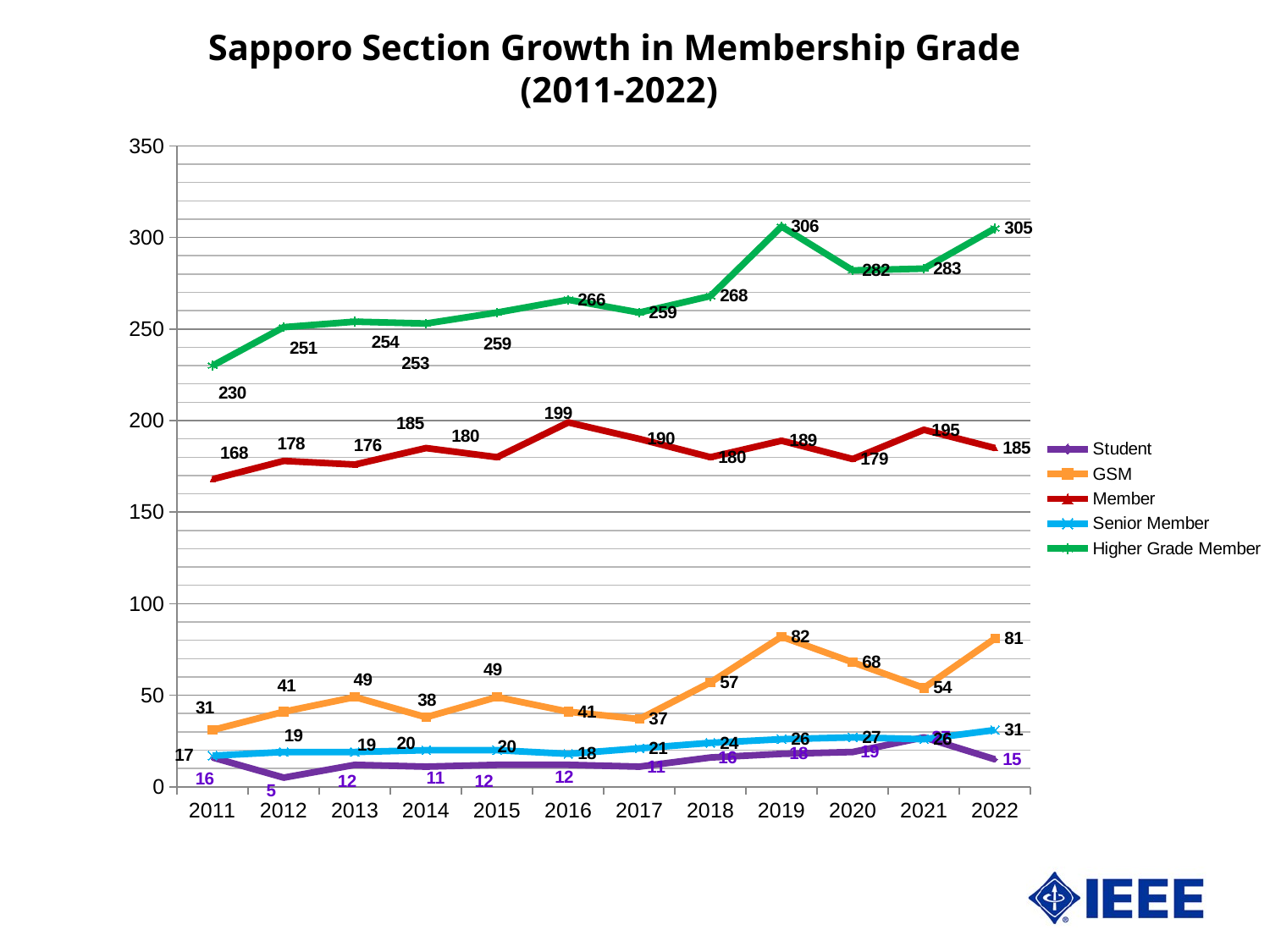
Which is larger, the GSM value in 2019 or in 2022? 2019 What is the value for GSM in 2019? 82 What is the value for Higher Grade Member in 2019? 306 How many years are plotted on the x axis? 12 What kind of chart is shown on the slide? line chart What is the value for Member in 2016? 199 In which year is the Higher Grade Member value highest? 2019 In which year is the Student value lowest? 2012 What is the value for Senior Member in 2022? 31 How many series does the legend list? 5 By how much did the Higher Grade Member value increase from 2011 to 2022? 75 What colour is the Higher Grade Member line? green